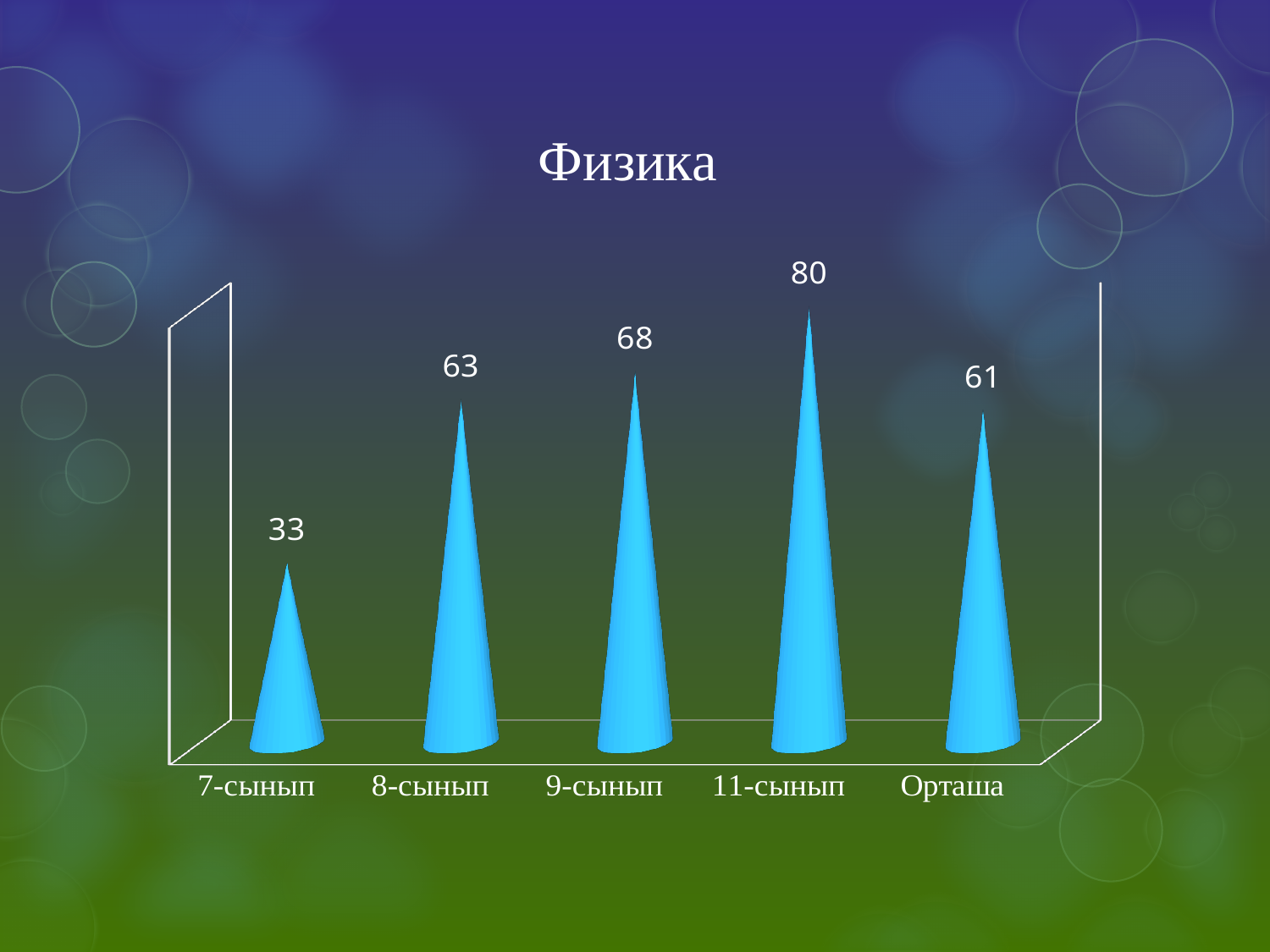
What is the value for 7-сынып? 33 What is the value for Орташа? 61 What is the difference between the values for 11-сынып and 7-сынып? 47 What is the title of the chart? Физика What is the value for 9-сынып? 68 What kind of chart is this? bar chart What is the value for 11-сынып? 80 What is the value for 8-сынып? 63 Which is larger, the value for 9-сынып or the value for Орташа? 9-сынып Which category has the highest value? 11-сынып How many categories are shown on the x axis? 5 Which category has the lowest value? 7-сынып